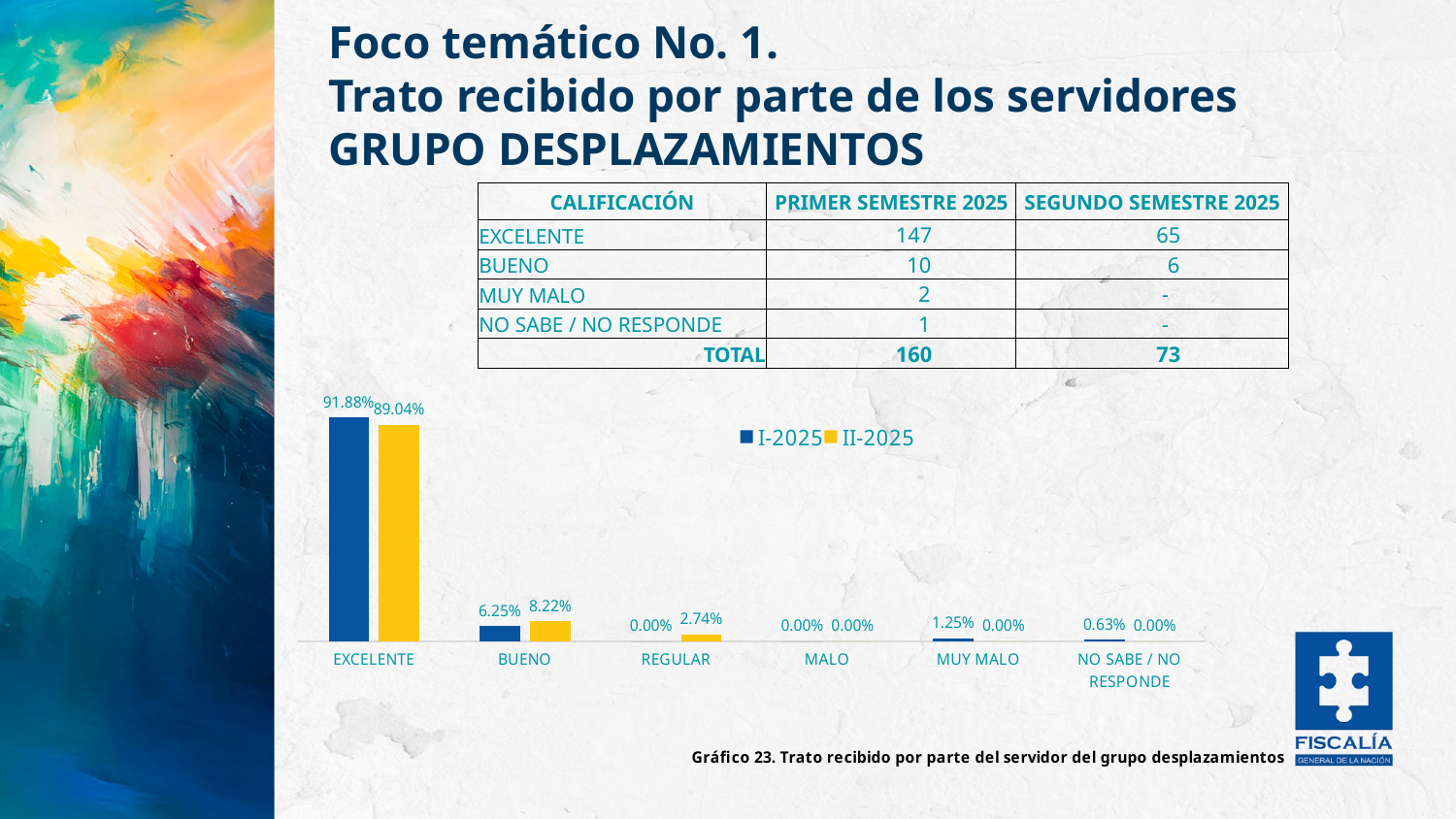
Which category has the highest value in the I-2025 series? EXCELENTE What is the value for BUENO in the II-2025 series? 8.22% What is the value for MUY MALO in the I-2025 series? 1.25% What is the value for REGULAR in the II-2025 series? 2.74% What is the difference between the I-2025 and II-2025 values for BUENO? 1.97% What is the value for NO SABE / NO RESPONDE in the I-2025 series? 0.63% What is the value for EXCELENTE in the I-2025 series? 91.88% How many series does the chart legend list? 2 What is the value for EXCELENTE in the II-2025 series? 89.04% How many categories are shown on the x axis of the chart? 6 Which is larger for EXCELENTE, the I-2025 value or the II-2025 value? I-2025 What kind of chart is shown on the slide? Bar chart